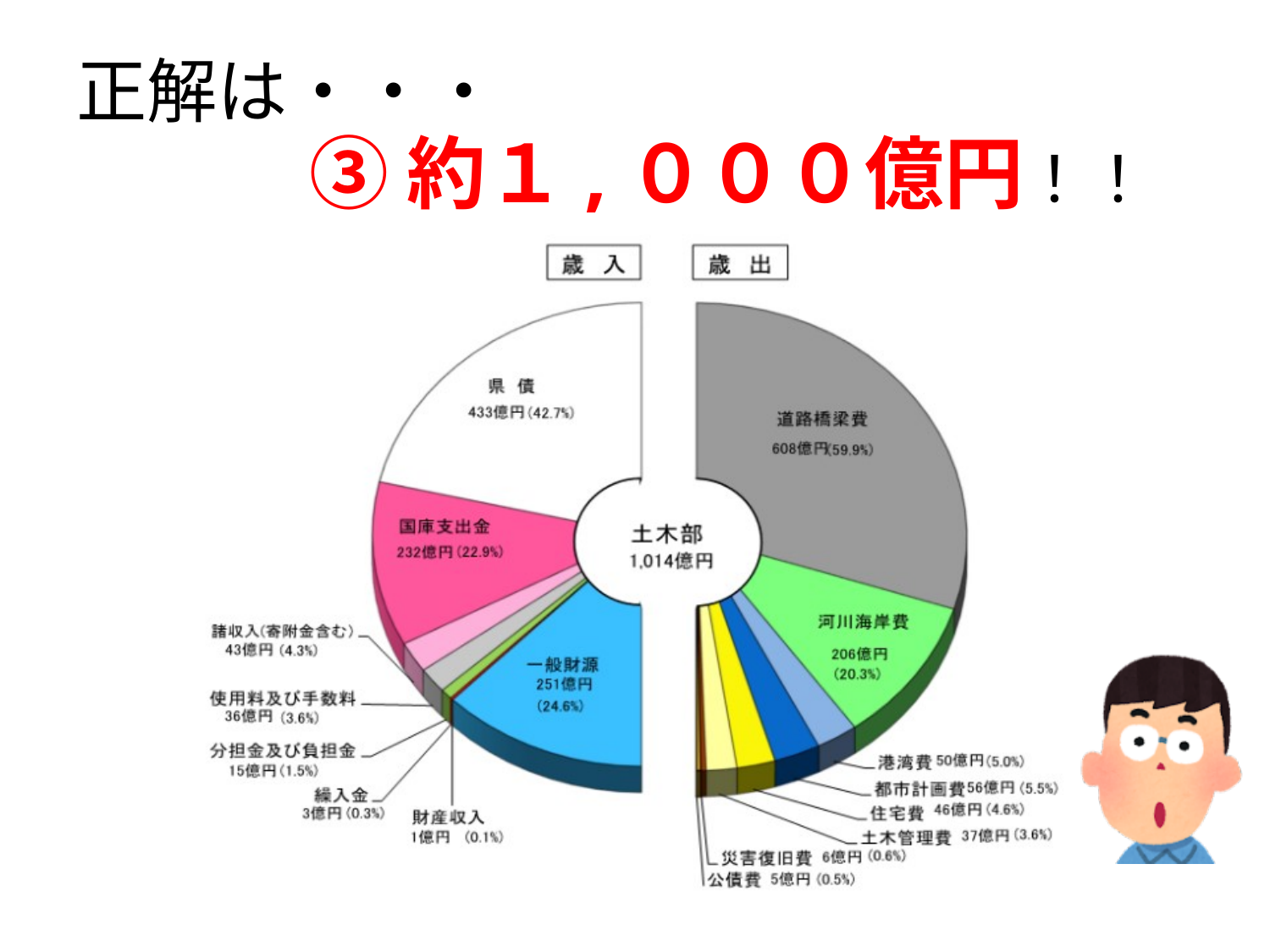
On the 歳出 (expenditure) side of the chart, what is the value for 道路橋梁費? 608億円 (59.9%) On the 歳出 side of the chart, what is the difference between 道路橋梁費 and 河川海岸費? 402億円 On the 歳入 side of the chart, which is larger: 一般財源 or 国庫支出金? 一般財源 How many categories are shown on the 歳出 side of the chart? 8 On the 歳入 side of the chart, which category is the largest? 県債 What is the total amount shown in the centre of the chart for 土木部? 1,014億円 On the 歳出 side of the chart, what is the value for 都市計画費? 56億円 (5.5%) On the 歳入 (revenue) side of the chart, what is the value for 県債? 433億円 (42.7%) On the 歳入 side of the chart, which category is the smallest? 財産収入 What type of chart is shown on the slide? pie chart On the 歳出 side of the chart, what share does 河川海岸費 represent? 20.3% On the 歳出 side of the chart, which category is the smallest? 公債費